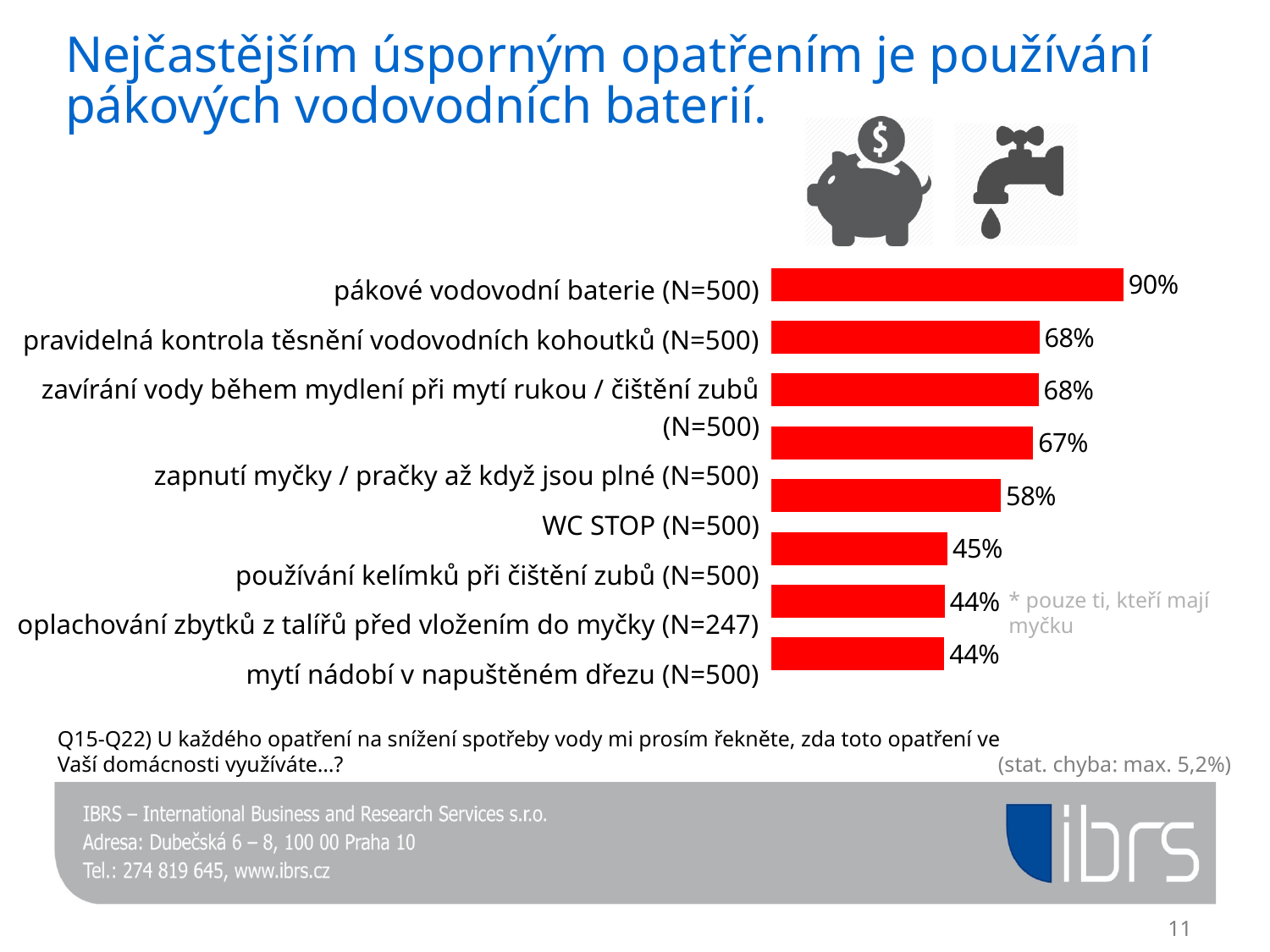
What is the difference in percentage points between 'pákové vodovodní baterie' (90%) and 'mytí nádobí v napuštěném dřezu' (44%)? 46 percentage points What percentage is shown for 'zapnutí myčky / pračky až když jsou plné (N=500)'? 67% How many bars (measures) are shown in the chart? 8 What type of chart is shown on the slide? bar chart What percentage is shown for 'WC STOP (N=500)'? 58% What percentage is shown for 'oplachování zbytků z talířů před vložením do myčky (N=247)'? 44% What maximum statistical error is stated on the slide? max. 5,2% What does the footnote next to the chart say about the N=247 measure? * pouze ti, kteří mají myčku Which has a higher percentage: 'WC STOP (N=500)' or 'používání kelímků při čištění zubů (N=500)'? WC STOP (N=500) What percentage is shown for 'pákové vodovodní baterie (N=500)'? 90% Which measure has the highest percentage in the chart? pákové vodovodní baterie (N=500) What is the lowest percentage value shown in the chart? 44%